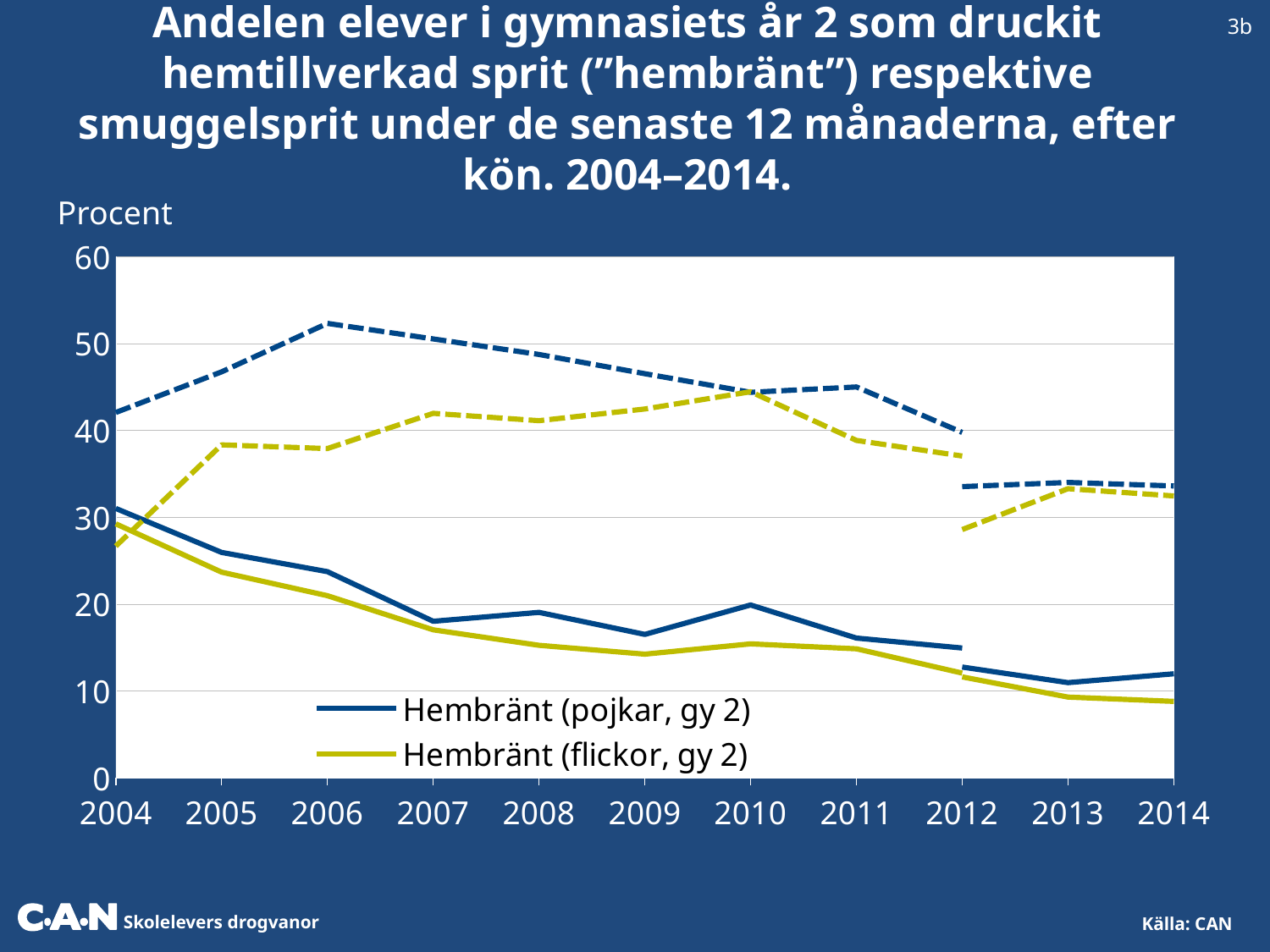
In which year is the value for Hembränt (pojkar, gy 2) highest? 2004 How many series does the chart's legend list? 2 What colour is the line for Hembränt (pojkar, gy 2) in the legend? blue Is the value for Hembränt (flickor, gy 2) in 2005 greater or less than 20? greater Does the value for Hembränt (flickor, gy 2) rise or fall from 2004 to 2014? fall In 2010, which is larger: Hembränt (pojkar, gy 2) or Hembränt (flickor, gy 2)? Hembränt (pojkar, gy 2) How many years are shown along the x axis of the chart? 11 What label is shown on the y axis of the chart? Procent Is the value for Hembränt (flickor, gy 2) in 2014 greater or less than 10? less Is the value for Hembränt (pojkar, gy 2) in 2006 greater or less than 30? less What kind of chart is shown on the slide? line chart